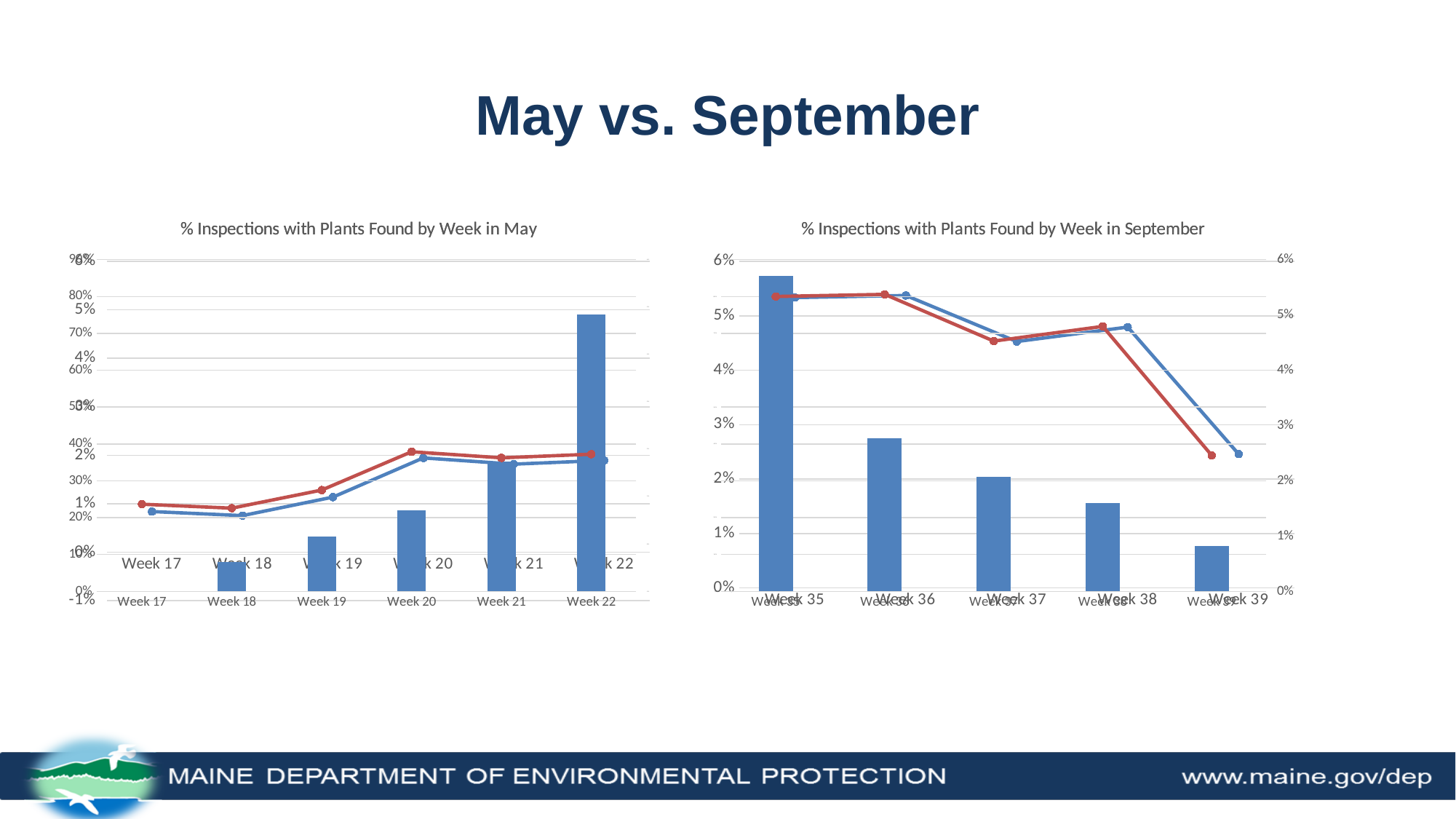
In the chart titled '% Inspections with Plants Found by Week in September', is the bar for Week 35 greater or less than 5%? greater In the chart titled '% Inspections with Plants Found by Week in May', do the line values generally rise or fall from Week 17 to Week 22? rise In the chart titled '% Inspections with Plants Found by Week in September', is the bar for Week 36 taller or shorter than the bar for Week 37? taller In the chart titled '% Inspections with Plants Found by Week in May', which week has the tallest bar? Week 22 In the chart titled '% Inspections with Plants Found by Week in May', how many weeks are shown on the x axis? 6 In the chart titled '% Inspections with Plants Found by Week in September', do the bar values rise or fall from Week 35 to Week 39? fall In the chart titled '% Inspections with Plants Found by Week in September', which week has the shortest bar? Week 39 In the chart titled '% Inspections with Plants Found by Week in September', which week has the tallest bar? Week 35 What is the title of the slide? May vs. September In the chart titled '% Inspections with Plants Found by Week in September', how many weeks are shown on the x axis? 5